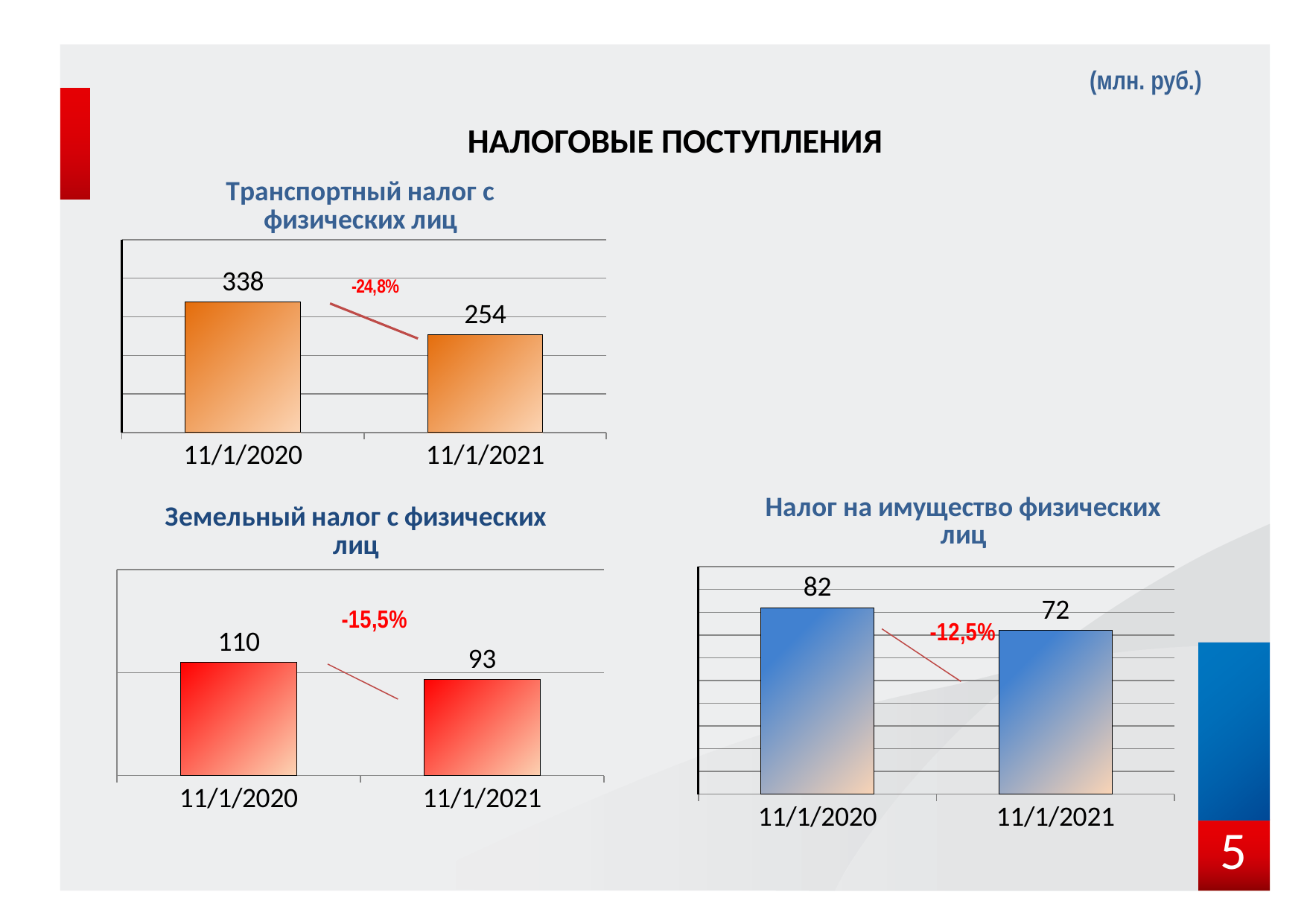
In the chart titled 'Налог на имущество физических лиц', what is the difference between the 11/1/2020 and 11/1/2021 values? 10 In the chart titled 'Земельный налог с физических лиц', which date has the lower value? 11/1/2021 What percentage change is labelled on the chart titled 'Налог на имущество физических лиц'? -12,5% In the chart titled 'Налог на имущество физических лиц', which date has the higher value? 11/1/2020 In the chart titled 'Транспортный налог с физических лиц', what is the value for 11/1/2021? 254 In the chart titled 'Транспортный налог с физических лиц', what is the value for 11/1/2020? 338 How many bars are shown in the chart titled 'Земельный налог с физических лиц'? 2 In the chart titled 'Налог на имущество физических лиц', what is the value for 11/1/2020? 82 In the chart titled 'Земельный налог с физических лиц', what is the value for 11/1/2021? 93 In the chart titled 'Земельный налог с физических лиц', what is the value for 11/1/2020? 110 In the chart titled 'Транспортный налог с физических лиц', what is the difference between the 11/1/2020 and 11/1/2021 values? 84 In the chart titled 'Транспортный налог с физических лиц', do the values rise or fall from 11/1/2020 to 11/1/2021? fall